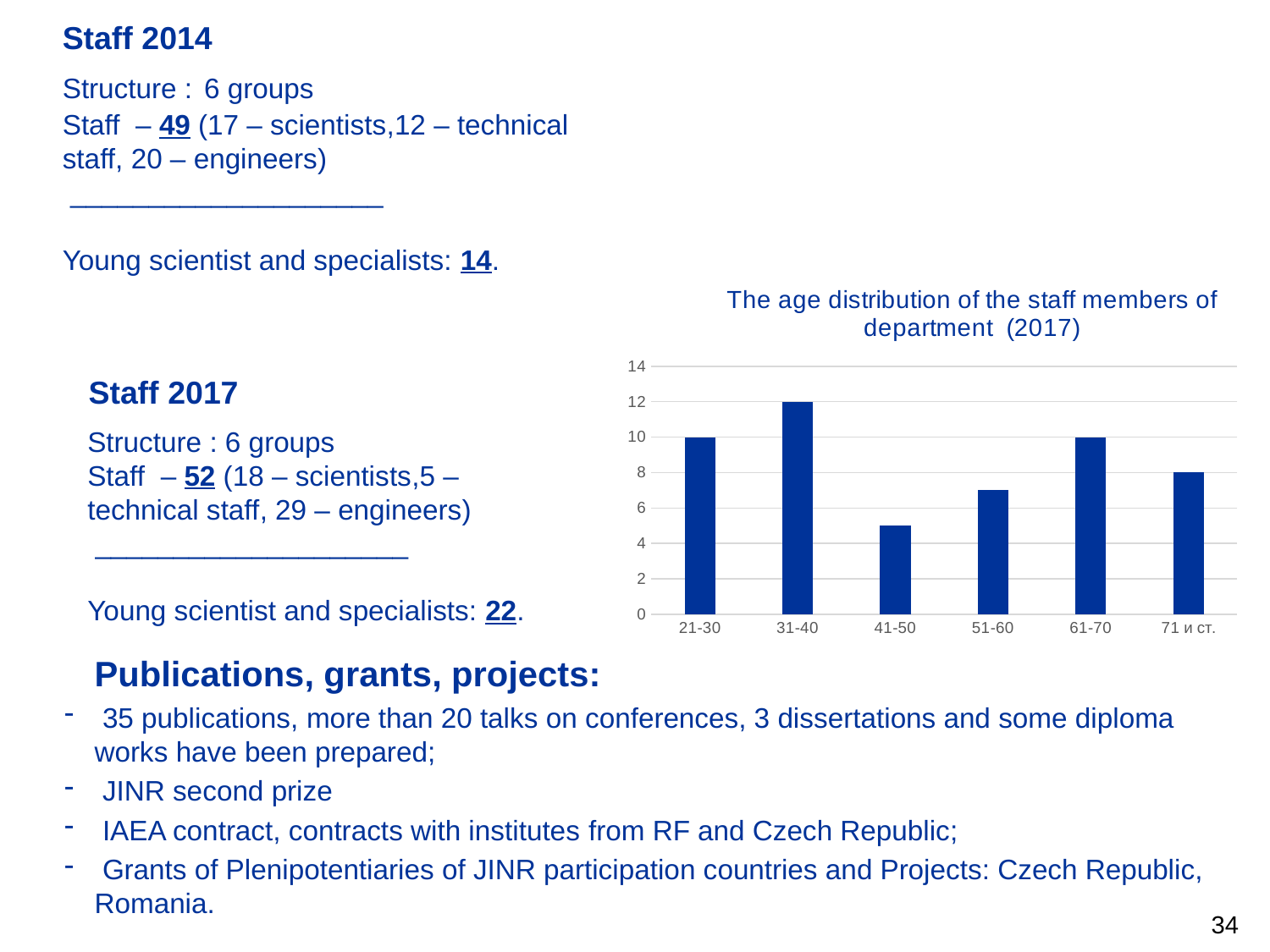
What is the difference between the values for the 31-40 and 71 и ст. age groups? 4 How many age categories are shown on the x axis of the chart? 6 Which age group has the lowest value? 41-50 What is the title of the chart? The age distribution of the staff members of department (2017) Is the value for the 51-60 age group greater or less than 6? greater What kind of chart is shown on the slide? bar chart Is the value for the 41-50 age group greater or less than 6? less What is the value for the 21-30 age group? 10 What is the value for the 71 и ст. age group? 8 Which age group has the highest value? 31-40 What is the value for the 31-40 age group? 12 What is the value for the 61-70 age group? 10